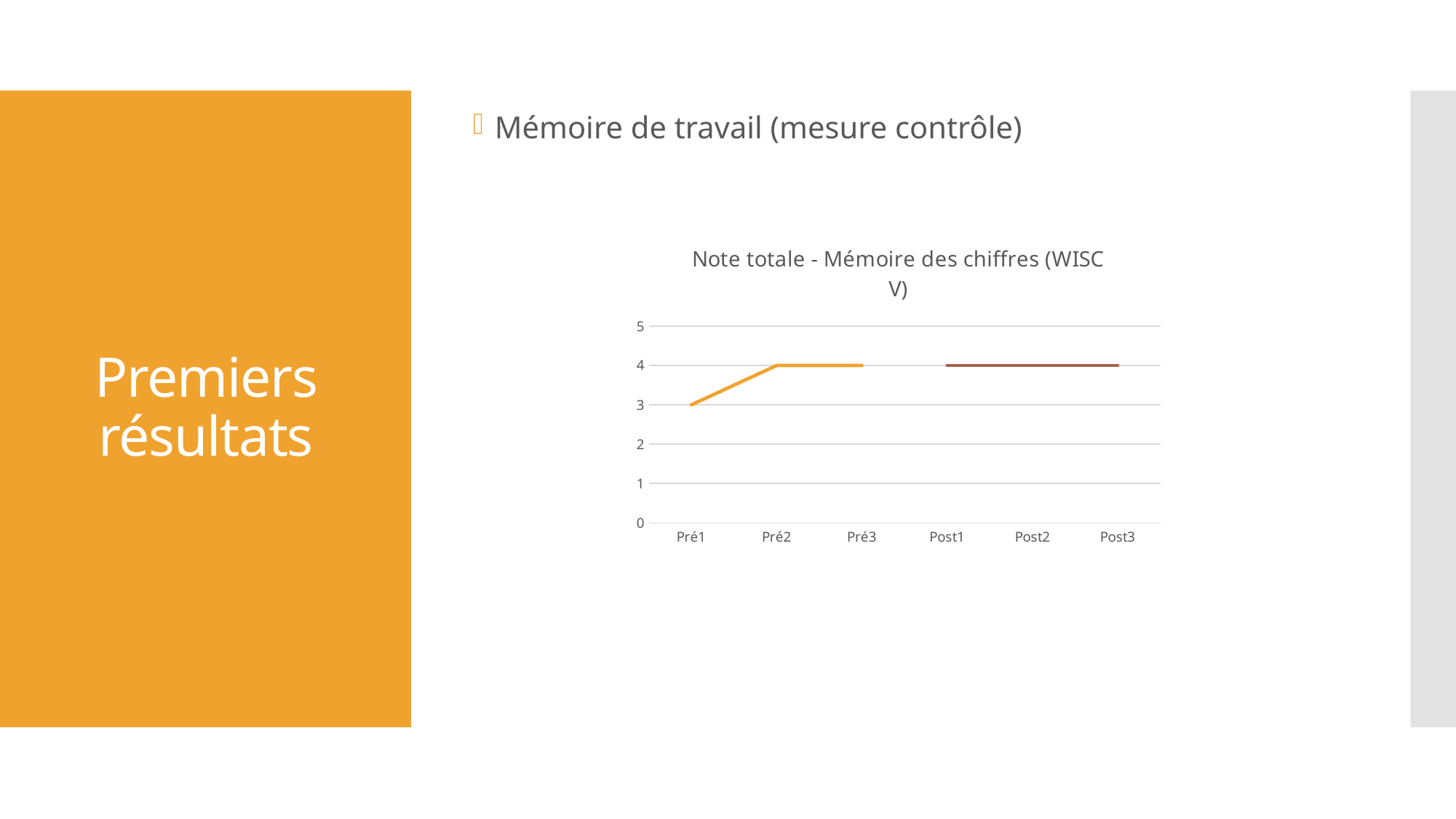
What is the difference between the values for Pré2 and Pré1? 1 What kind of chart is shown on the slide? line chart What is the title of the chart? Note totale - Mémoire des chiffres (WISC V) Is the value for Pré1 greater or less than 4? less Which is larger, the value for Pré1 or the value for Post1? Post1 What is the value for Pré2? 4 What colour is the line segment covering the Post1 to Post3 categories? brown What is the value for Post3? 4 Does the value rise or fall from Pré1 to Pré2? rise Which category has the lowest value? Pré1 What is the value for Pré1? 3 How many categories are shown on the x axis of the chart? 6